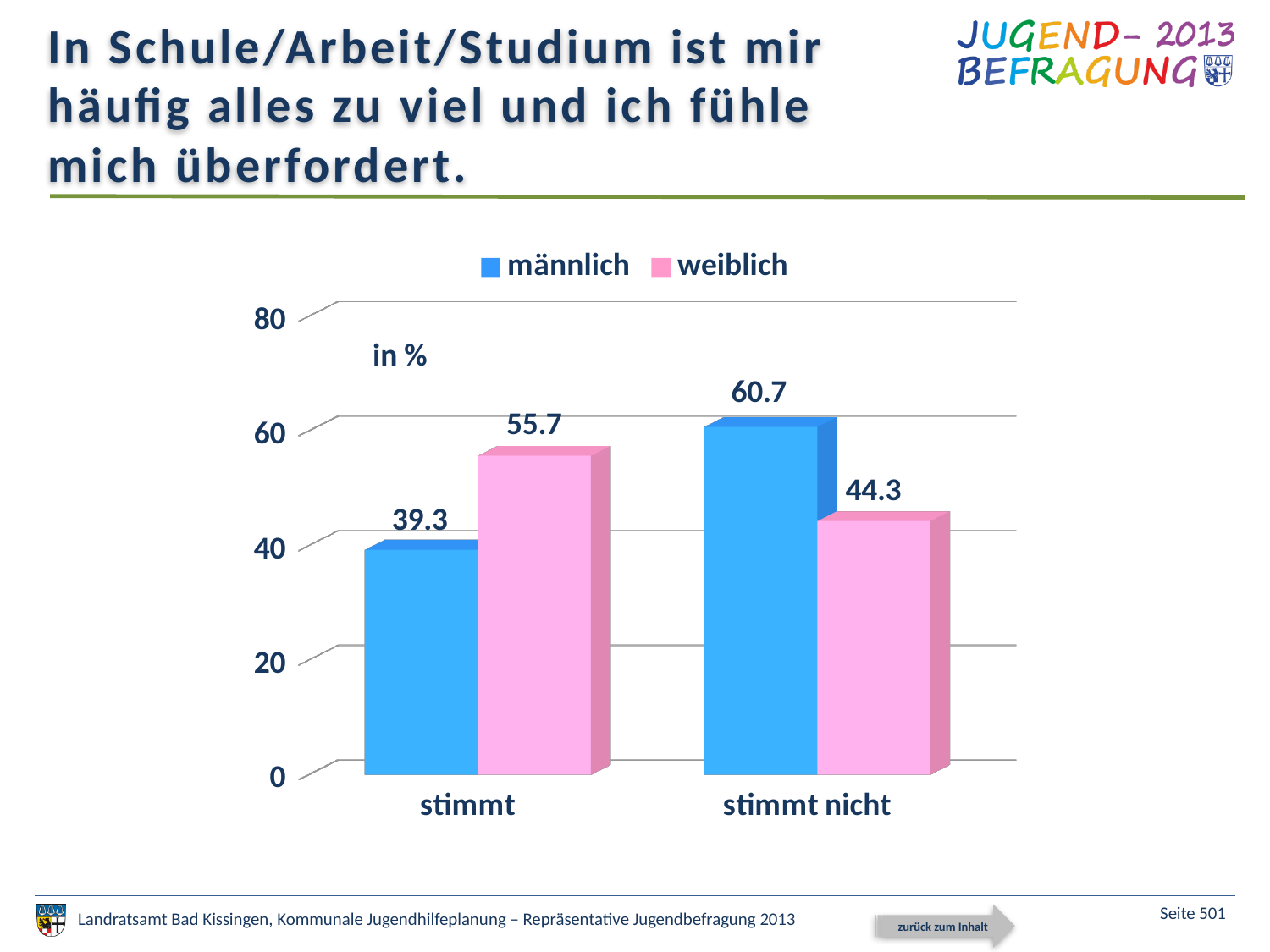
What is the value for männlich in the stimmt category? 39.3 What is the value for männlich in the stimmt nicht category? 60.7 What is the value for weiblich in the stimmt nicht category? 44.3 Which bar has the highest value in the chart? männlich, stimmt nicht What is the difference between the weiblich and männlich values in the stimmt category? 16.4 How many categories are shown on the x axis? 2 Is the value for weiblich in the stimmt nicht category greater or less than 40? greater Which bar has the lowest value in the chart? männlich, stimmt What kind of chart is shown on the slide? bar chart How many series does the legend list? 2 Which is larger in the stimmt nicht category, männlich or weiblich? männlich What is the value for weiblich in the stimmt category? 55.7